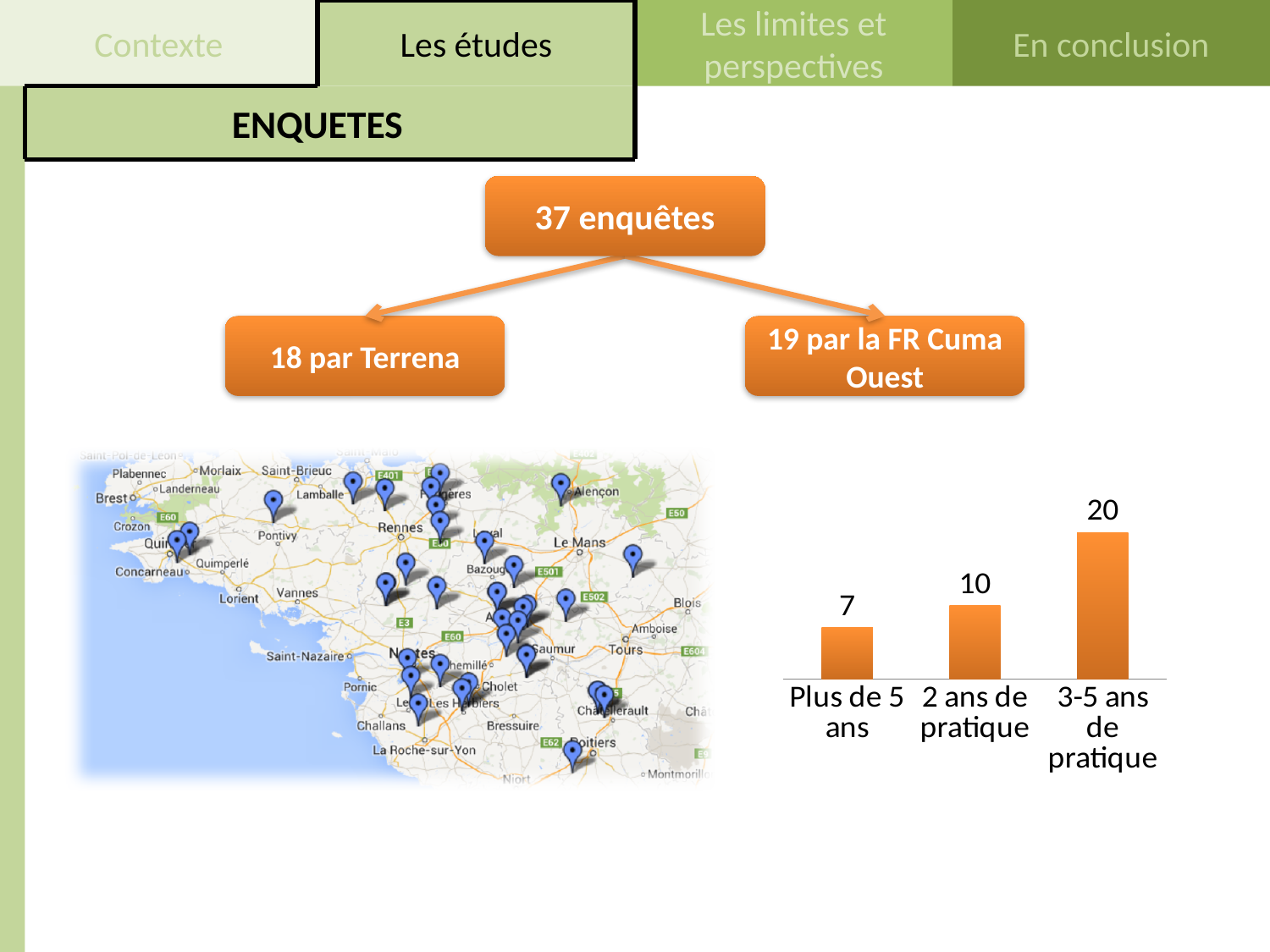
Which category has the lowest value in the bar chart? Plus de 5 ans What is the value for "Plus de 5 ans" in the bar chart? 7 How many categories are shown in the bar chart? 3 Which is larger: the value for "2 ans de pratique" or the value for "Plus de 5 ans"? 2 ans de pratique What is the difference between the values for "3-5 ans de pratique" and "2 ans de pratique"? 10 What kind of chart is shown on the slide? bar chart Do the values in the bar chart rise or fall from left to right? rise Which category has the highest value in the bar chart? 3-5 ans de pratique What is the value for "2 ans de pratique" in the bar chart? 10 What colour are the bars in the chart? orange What is the value for "3-5 ans de pratique" in the bar chart? 20 What is the difference between the values for "2 ans de pratique" and "Plus de 5 ans"? 3